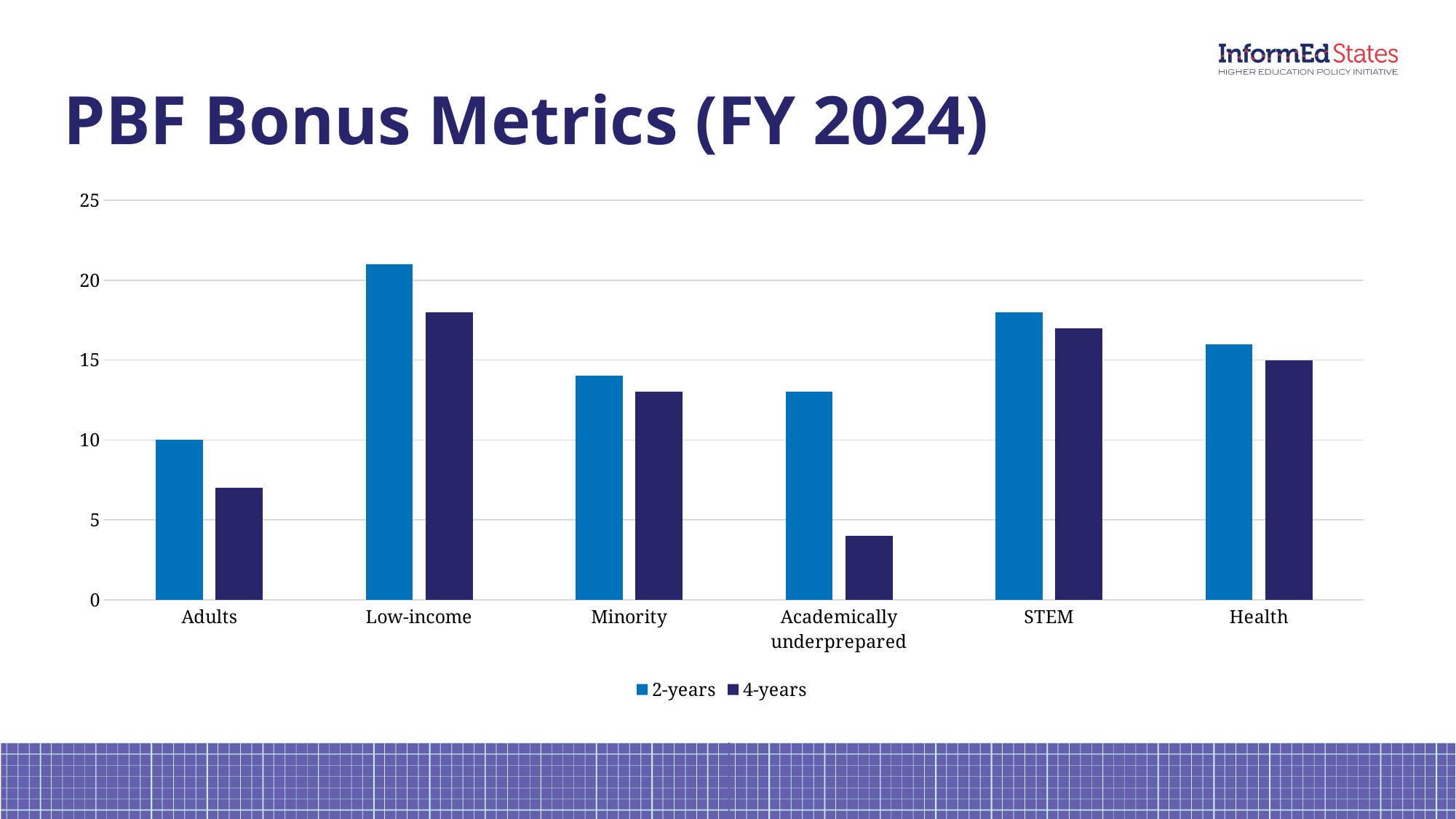
What type of chart is shown on the slide? bar chart Which category has the larger 2-years value, STEM or Health? STEM How many categories are shown on the x axis of the chart? 6 Which category has the highest 2-years value? Low-income Which category has the lowest 4-years value? Academically underprepared Is the 4-years value for STEM greater or less than 15? greater Is the 4-years value for Academically underprepared greater or less than 5? less What is the value for Adults in the 2-years series? 10 How many series does the chart's legend list? 2 What is the title of the slide's chart? PBF Bonus Metrics (FY 2024) Is the 2-years value for Low-income greater or less than 20? greater For Adults, which series has the larger value, 2-years or 4-years? 2-years